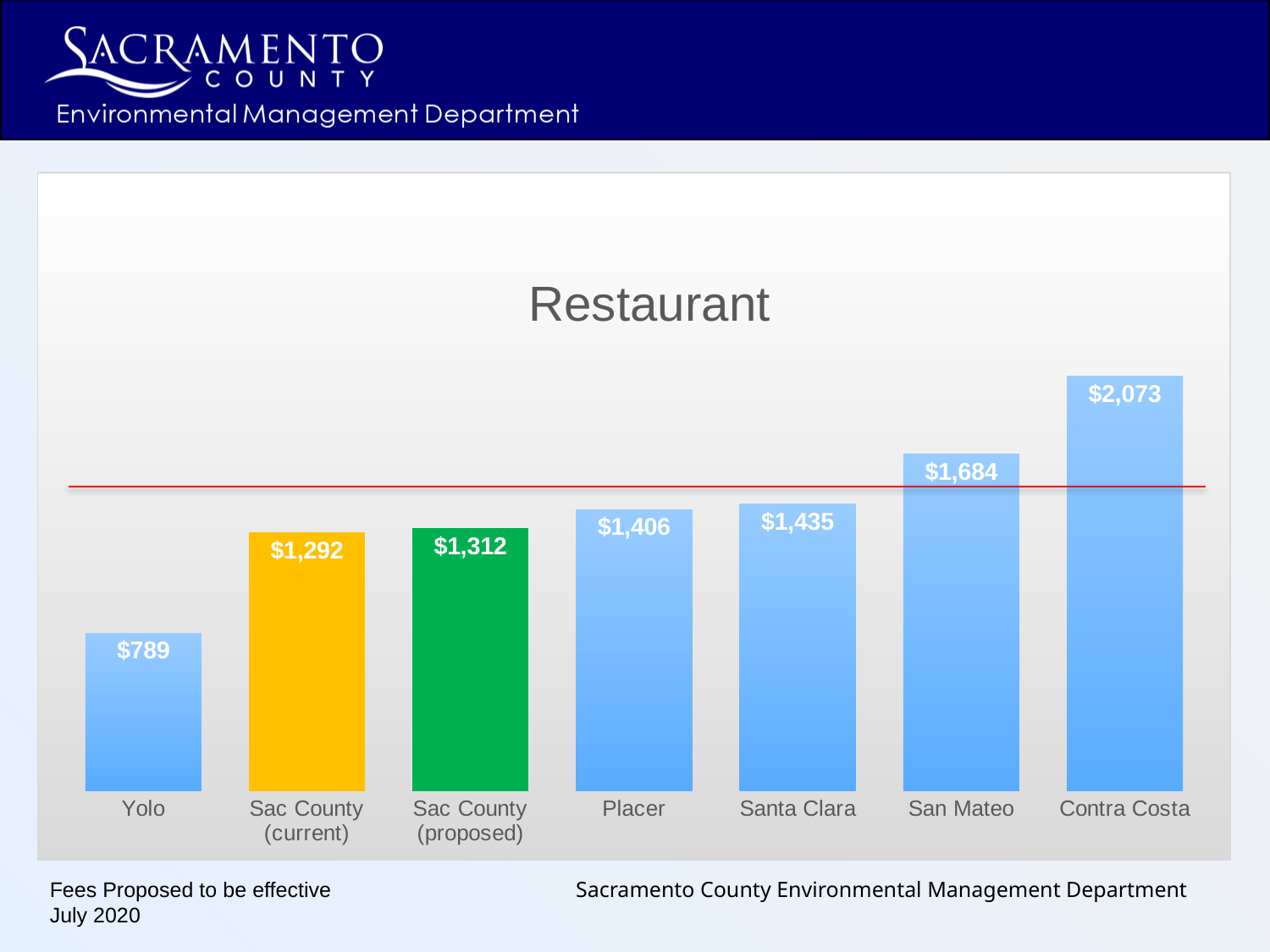
What kind of chart is this? Bar chart Which category has the lowest value? Yolo What colour is the Sac County (proposed) bar? Green What is the title of the chart? Restaurant How many categories are shown in the chart? 7 Which category has the highest value? Contra Costa What is the difference between Sac County (proposed) and Sac County (current)? $20 What is the value for Sac County (proposed)? $1,312 What is the value for Yolo? $789 Which is larger, Placer or Santa Clara? Santa Clara What is the difference between Contra Costa and Yolo? $1,284 What is the value for San Mateo? $1,684